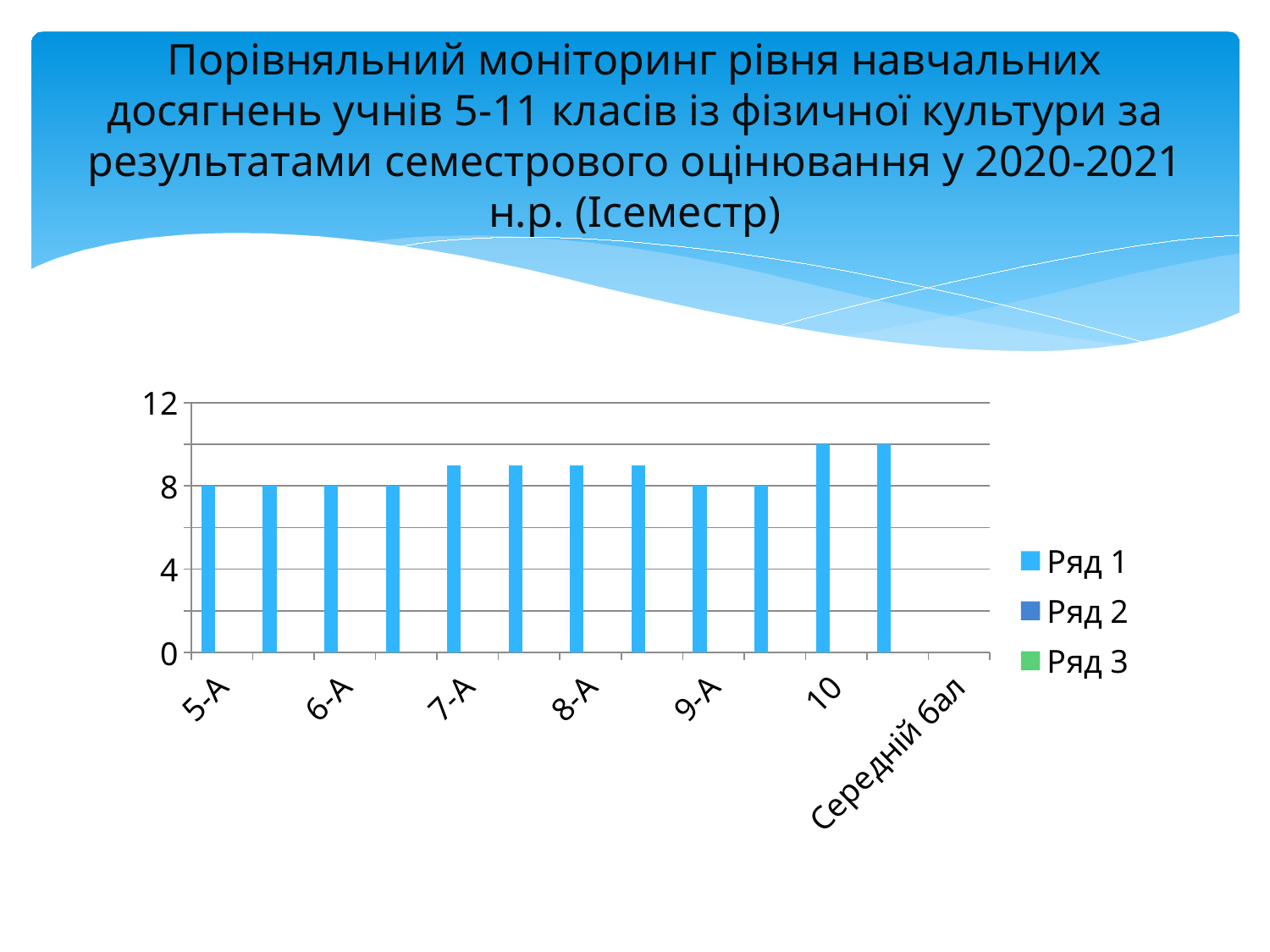
Is the value for 7-А greater or less than 8? greater What is the value for 9-А? 8 Which is larger, the value for 10 or the value for 9-А? 10 What kind of chart is shown on the slide? bar chart Which is larger, the value for 7-А or the value for 5-А? 7-А Is the value for 8-А greater or less than 8? greater What is the value for 6-А? 8 What is the first entry in the chart's legend? Ряд 1 Is the value for 10 greater or less than 12? less How many series does the legend list? 3 What is the value for 5-А? 8 How many bars are plotted in the chart? 12